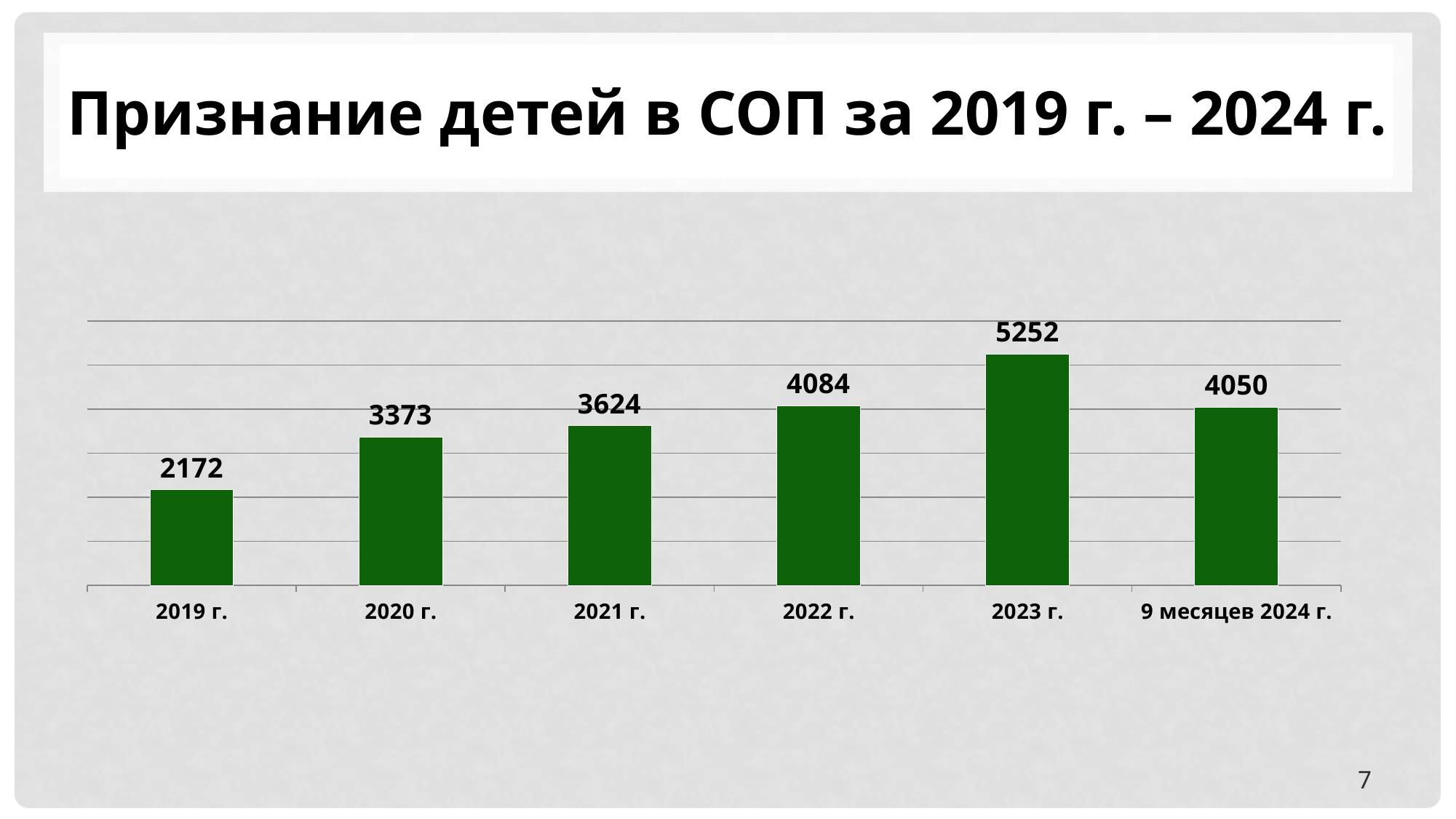
Which is larger, the value for 2022 г. or the value for 9 месяцев 2024 г.? 2022 г. How many categories are shown on the x axis? 6 What is the value for 2019 г.? 2172 What is the difference between the values for 2023 г. and 2022 г.? 1168 What is the title of the slide? Признание детей в СОП за 2019 г. – 2024 г. What is the difference between the values for 2020 г. and 2019 г.? 1201 Which category has the highest value? 2023 г. Do the values rise or fall from 2019 г. to 2023 г.? rise Which category has the lowest value? 2019 г. What kind of chart is shown on the slide? bar chart What is the value for 2021 г.? 3624 What is the value for 9 месяцев 2024 г.? 4050